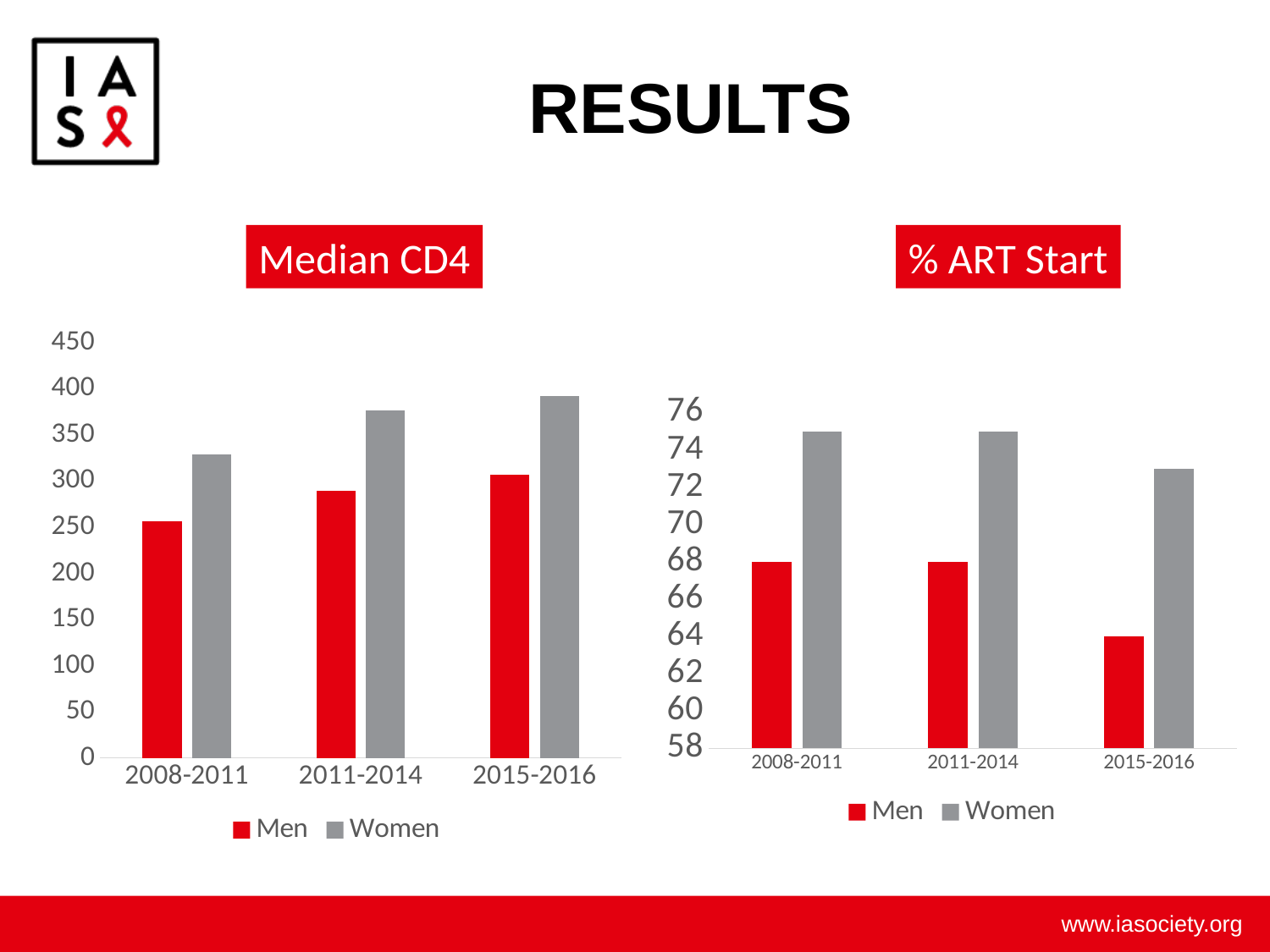
In the Median CD4 chart, which period has the highest value for Women? 2015-2016 In the Median CD4 chart, which period has the lowest value for Men? 2008-2011 In the % ART Start chart, which period has the lowest value for Men? 2015-2016 In the Median CD4 chart, is the value for Women in 2011-2014 greater or less than 350? greater In the Median CD4 chart, is the value for Men in 2008-2011 greater or less than 300? less How many series does the legend of the % ART Start chart list? 2 In the % ART Start chart, is the value for Women in 2008-2011 greater or less than 72? greater In the % ART Start chart, which is larger in 2015-2016, Men or Women? Women What colour are the Men bars in both charts? red What kind of chart is the Median CD4 chart? bar chart How many time-period categories are shown on the x axis of the Median CD4 chart? 3 In the Median CD4 chart, do the values for Men rise or fall from 2008-2011 to 2015-2016? rise